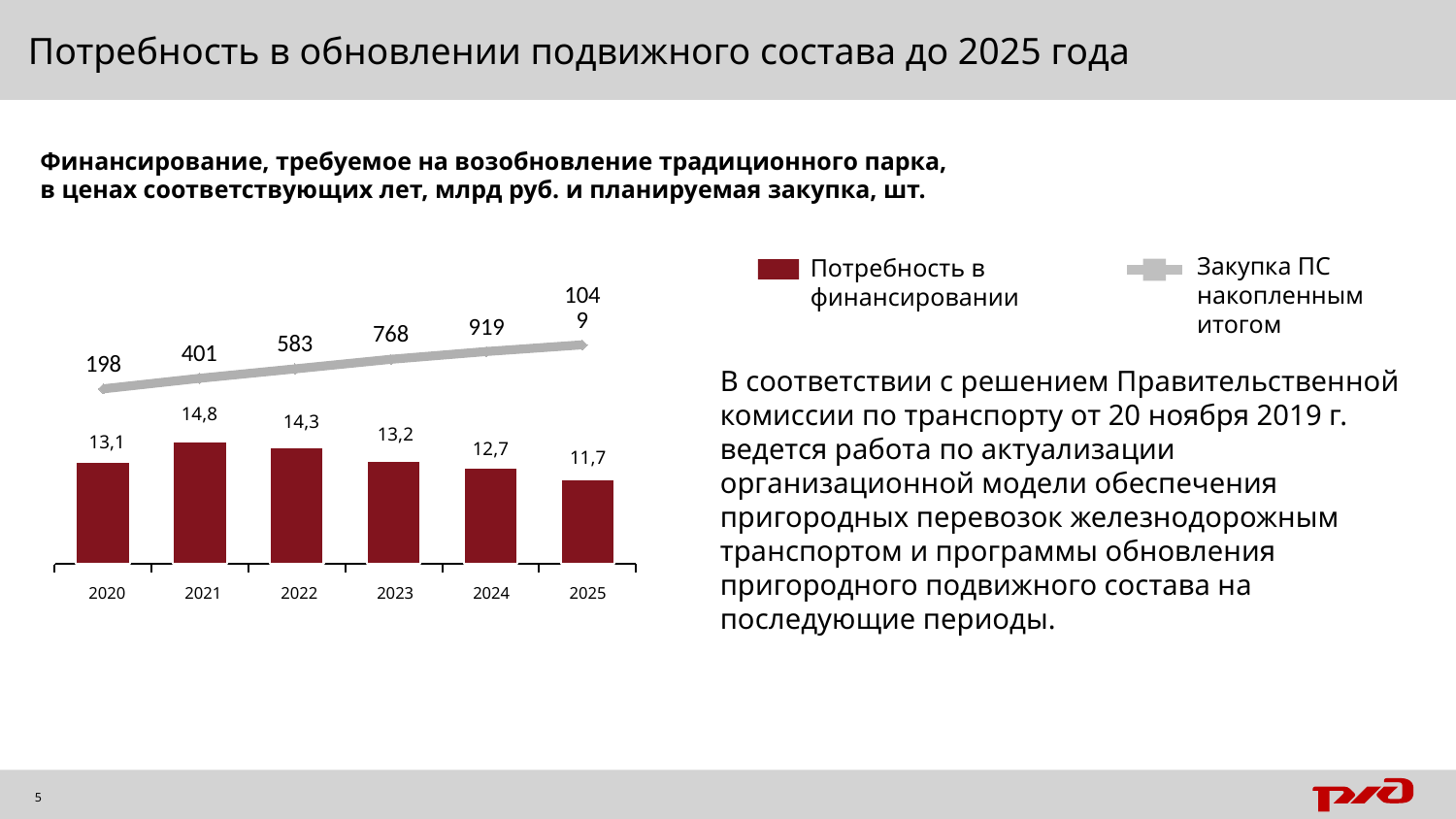
How many series does the legend list? 2 Which year has the highest Потребность в финансировании? 2021 Which year has the larger Потребность в финансировании, 2022 or 2023? 2022 Does Закупка ПС накопленным итогом rise or fall from 2020 to 2025? rises By how much does Закупка ПС накопленным итогом increase from 2022 to 2023? 185 What is the difference between Потребность в финансировании in 2021 and in 2025? 3,1 What is the value of Потребность в финансировании for 2021? 14,8 How many years are shown on the x axis of the chart? 6 Which year has the lowest Потребность в финансировании? 2025 What is the value of Закупка ПС накопленным итогом for 2020? 198 What is the value of Потребность в финансировании for 2024? 12,7 What is the value of Закупка ПС накопленным итогом for 2022? 583